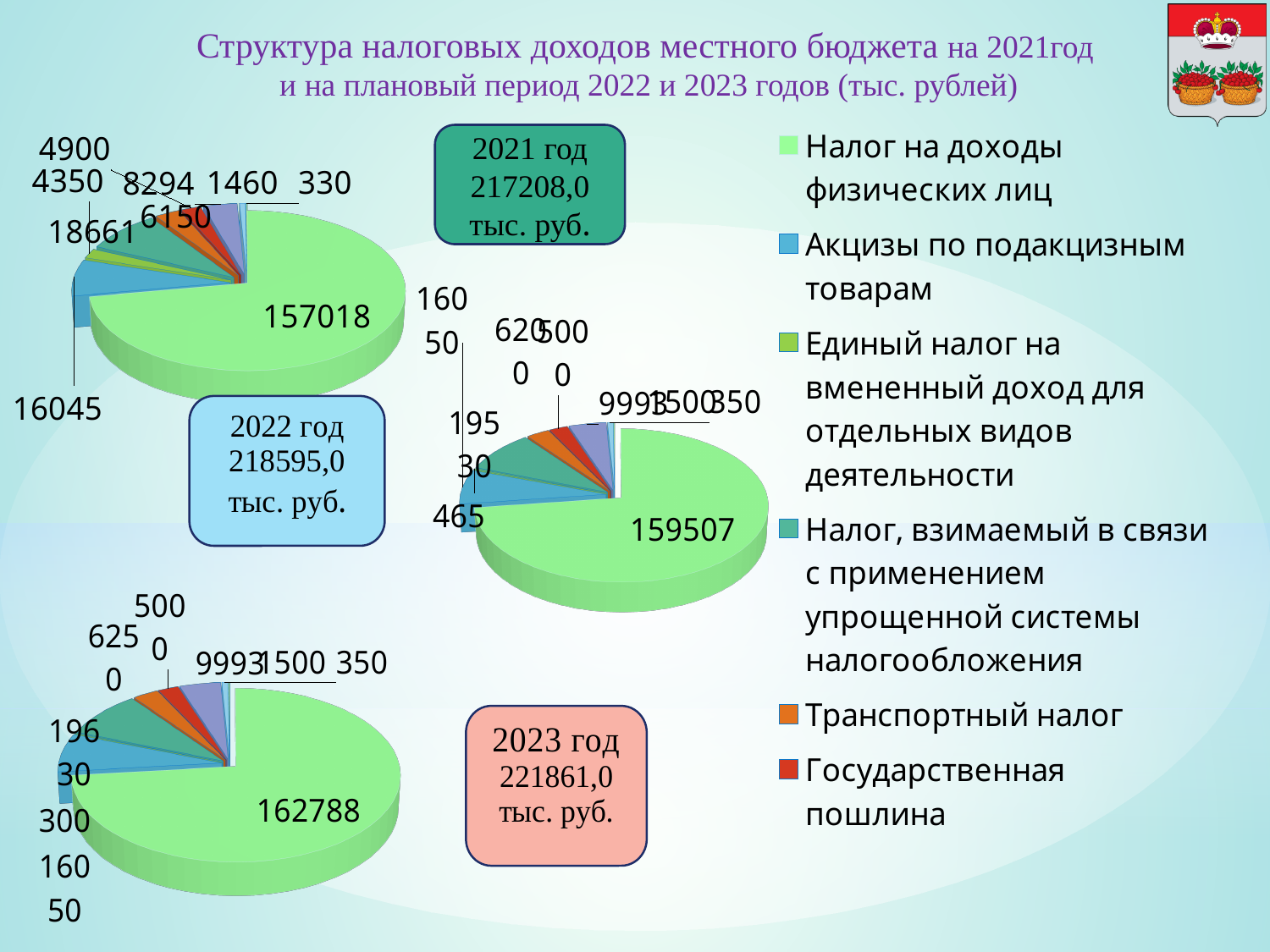
What kind of charts are shown on the slide? Pie charts In the 2022 pie chart, what is the value of the largest slice? 159507 According to the legend, which category does the largest (light green) slice in each pie chart represent? Налог на доходы физических лиц What is the difference between the largest slice of the 2023 pie chart (162788) and the largest slice of the 2021 pie chart (157018)? 5770 In the 2021 pie chart, what is the value of the largest slice? 157018 What is the difference between the largest slice of the 2022 pie chart (159507) and the largest slice of the 2021 pie chart (157018)? 2489 How many pie charts are on the slide? 3 How many categories does the legend list? 6 Is the largest slice of the 2022 pie chart greater or less than 150000? greater Which is larger: the largest slice of the 2023 pie chart or the largest slice of the 2021 pie chart? 2023 (162788) In the 2023 pie chart, what is the value of the largest slice? 162788 In the 2021 pie chart, what is the smallest labelled value? 330